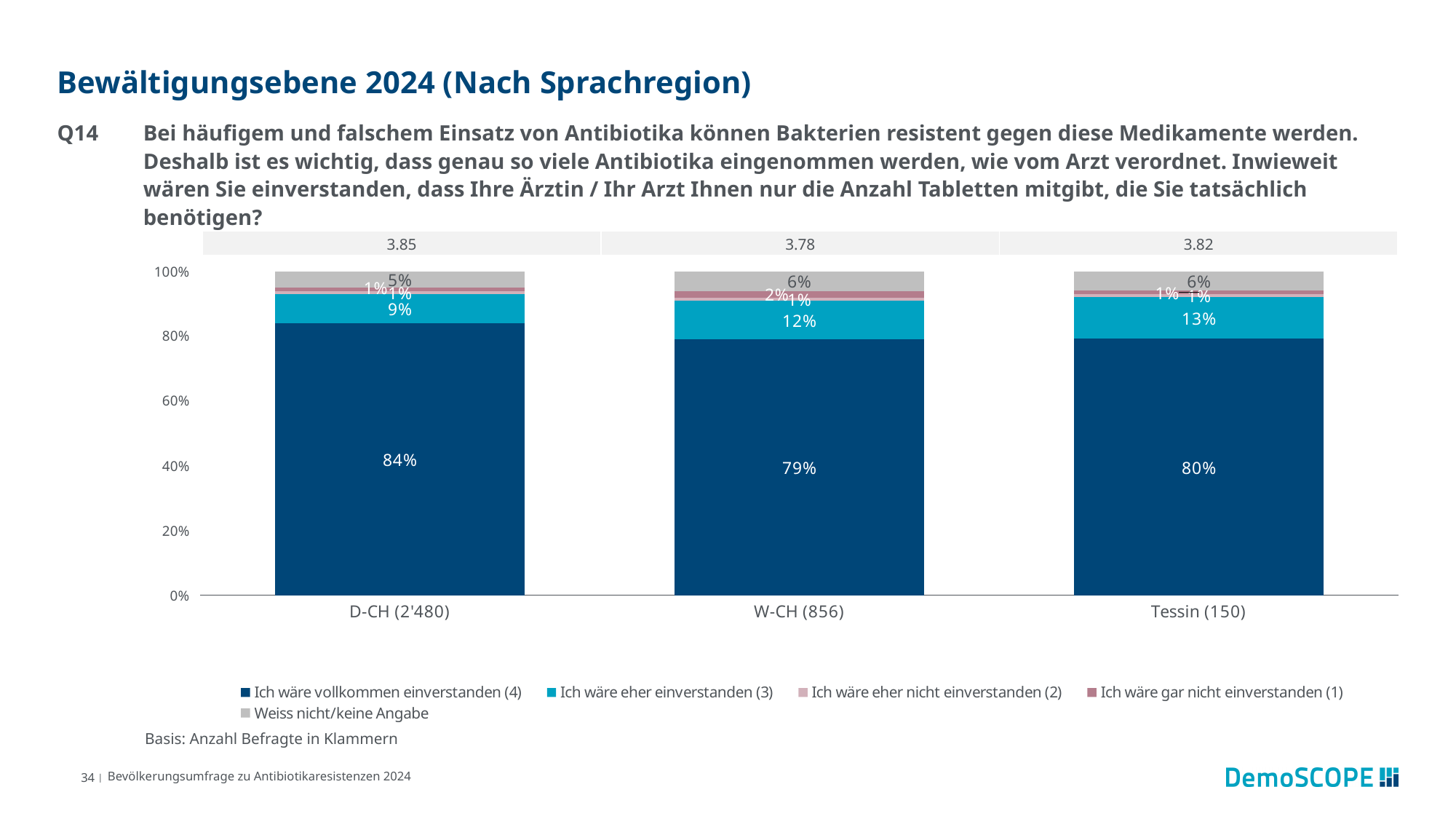
What kind of chart is shown on the slide? Stacked bar chart How many series does the legend list? 5 How many language regions are shown on the x axis? 3 Which language region has the highest mean score shown above the bars? D-CH (2'480) What percentage of respondents in Tessin (150) chose "Weiss nicht/keine Angabe"? 6% What percentage of respondents in W-CH (856) chose "Ich wäre eher einverstanden (3)"? 12% What is the mean score shown above the bar for W-CH (856)? 3.78 What percentage of respondents in D-CH (2'480) chose "Ich wäre vollkommen einverstanden (4)"? 84% Which is larger: the "Ich wäre eher einverstanden (3)" share for Tessin (150) or for W-CH (856)? Tessin (150) Which language region has the lowest share of "Ich wäre eher einverstanden (3)"? D-CH (2'480) What is the difference in the "Ich wäre vollkommen einverstanden (4)" share between D-CH (2'480) and W-CH (856)? 5 percentage points Which language region has the highest share of "Ich wäre vollkommen einverstanden (4)"? D-CH (2'480)